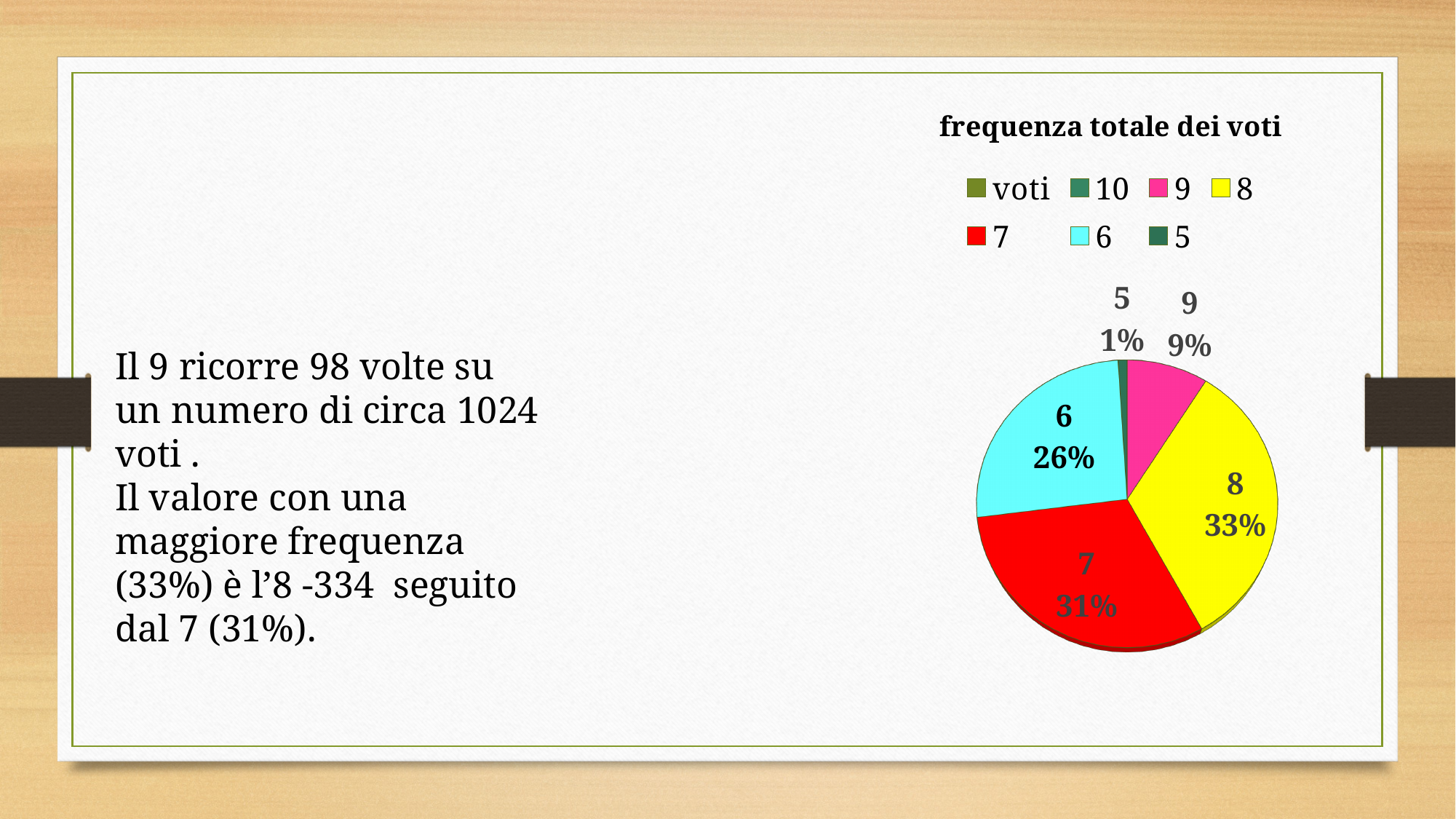
How many entries does the legend list? 7 What percentage of the pie does the slice for 6 represent? 26% What type of chart is shown on the slide? pie chart What percentage of the pie does the slice for 5 represent? 1% What is the difference in percentage points between the slices for 8 and 6? 7 What percentage of the pie does the slice for 9 represent? 9% Which slice is larger, the one for 7 or the one for 9? 7 Which labelled slice has the smallest share of the pie? 5 What percentage of the pie does the slice for 7 represent? 31% Which slice has the largest share of the pie? 8 What is the title of the chart? frequenza totale dei voti What percentage of the pie does the slice for 8 represent? 33%